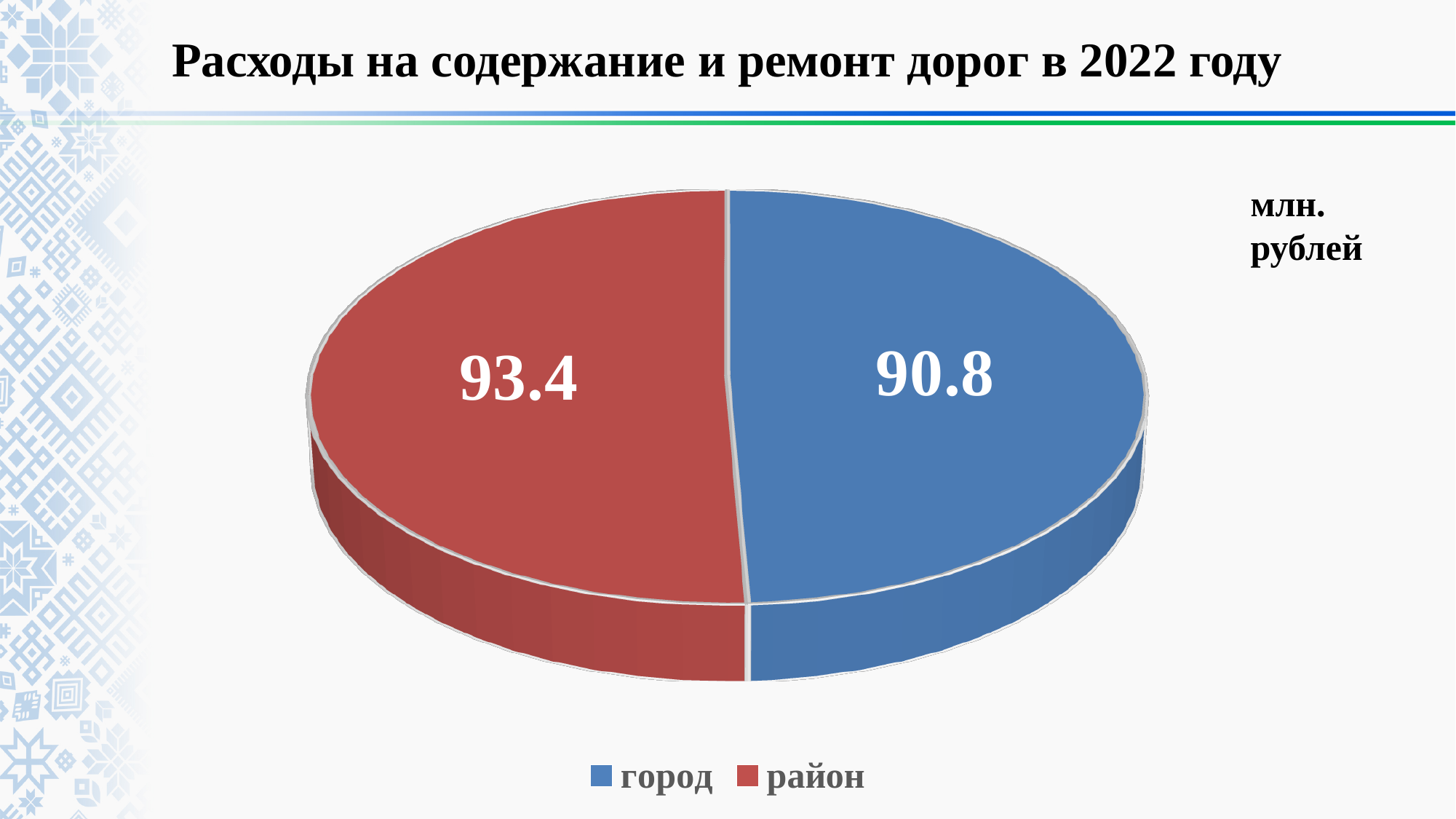
How many entries does the legend list? 2 What kind of chart is shown on the slide? pie chart Which category has the highest value? район How many slices does the pie chart have? 2 What is the value for город? 90.8 What is the title of the chart? Расходы на содержание и ремонт дорог в 2022 году What is the difference between the values for район and город? 2.6 Which category has the lowest value? город What is the value for район? 93.4 Which is larger, the value for город or the value for район? район What is the total of the two slices? 184.2 What colour is the slice for город? blue